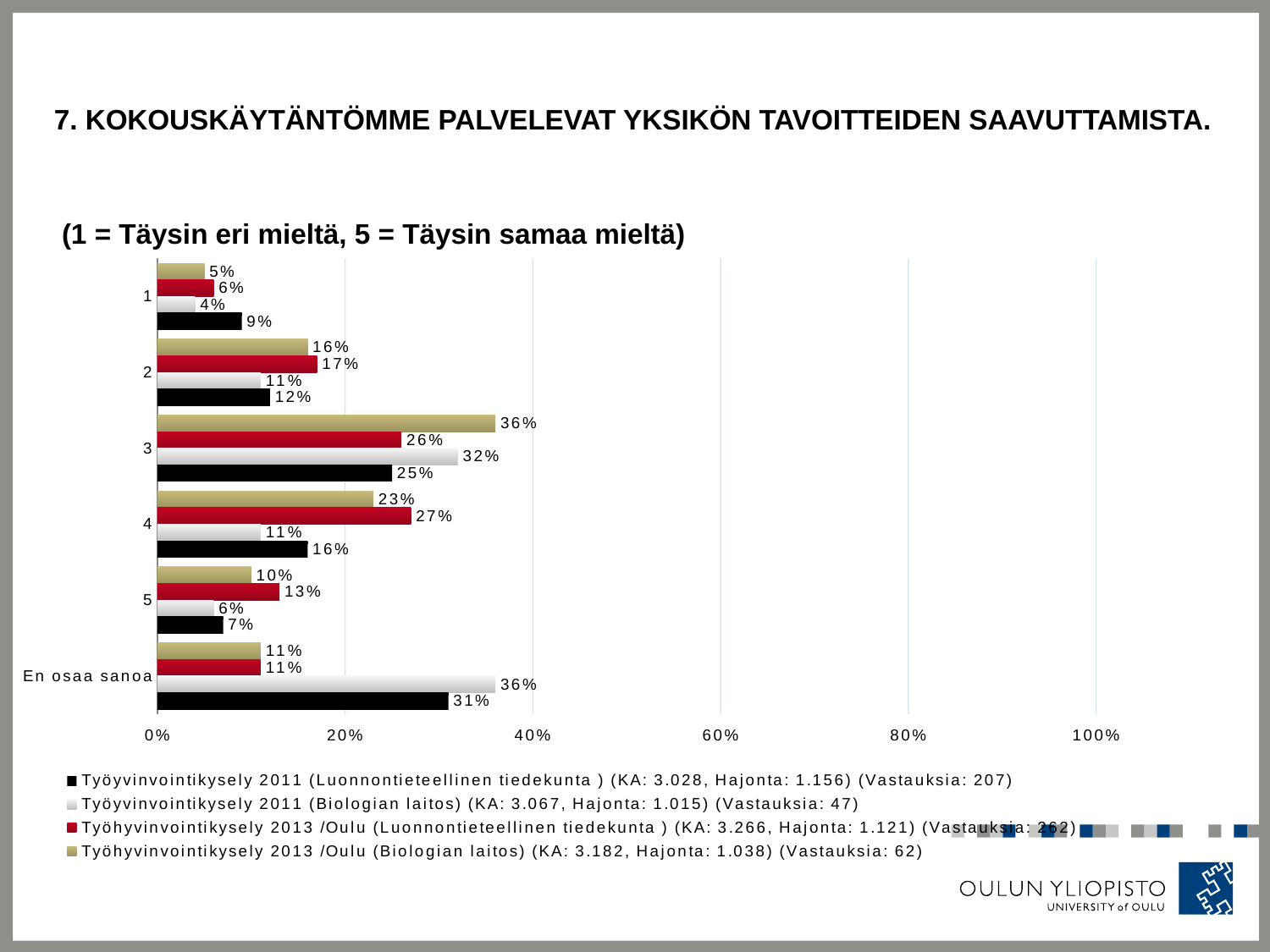
Which category has the lowest value in the Työhyvinvointikysely 2013 /Oulu (Biologian laitos) series? 1 What is the difference between the Työhyvinvointikysely 2013 /Oulu (Biologian laitos) value and the Työyvinvointikysely 2011 (Luonnontieteellinen tiedekunta) value for category 3? 11% For category 5, which is larger: the Työhyvinvointikysely 2013 /Oulu (Luonnontieteellinen tiedekunta) value or the Työyvinvointikysely 2011 (Biologian laitos) value? Työhyvinvointikysely 2013 /Oulu (Luonnontieteellinen tiedekunta) How many categories are shown on the vertical axis of the chart? 6 Which category has the highest value in the Työyvinvointikysely 2011 (Biologian laitos) series? En osaa sanoa Is the value for 'En osaa sanoa' in the Työyvinvointikysely 2011 (Biologian laitos) series greater or less than 20%? greater How many series does the legend list? 4 What kind of chart is shown on the slide? bar chart What is the value for category 3 in the Työhyvinvointikysely 2013 /Oulu (Biologian laitos) series? 36% What is the value for category 4 in the Työhyvinvointikysely 2013 /Oulu (Luonnontieteellinen tiedekunta) series? 27% What is the value for 'En osaa sanoa' in the Työyvinvointikysely 2011 (Luonnontieteellinen tiedekunta) series? 31% What is the value for category 2 in the Työyvinvointikysely 2011 (Biologian laitos) series? 11%